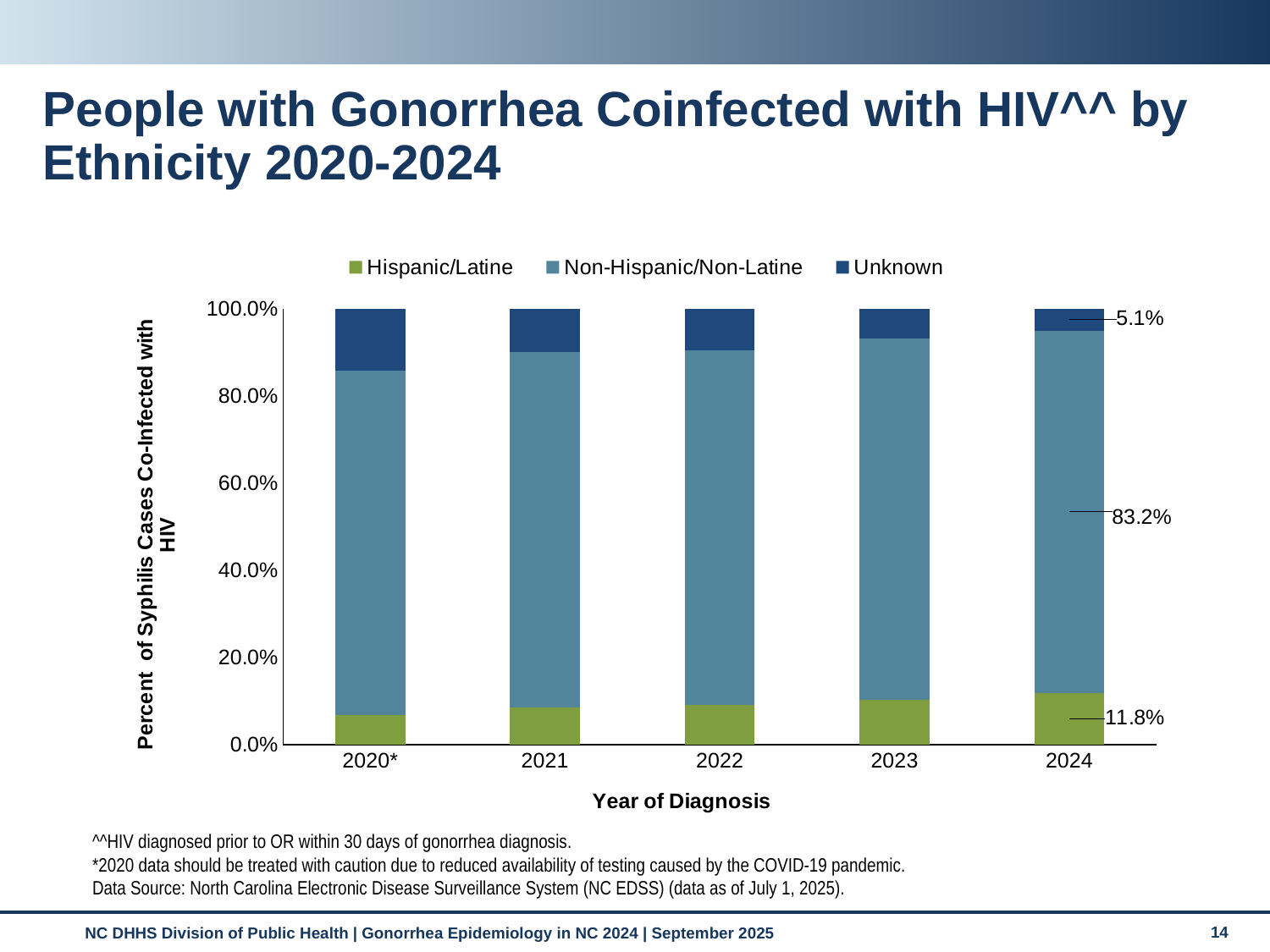
Which year has the largest Unknown share? 2020* Does the Hispanic/Latine share rise or fall from 2020* to 2024? Rise What is the Unknown ethnicity share shown for 2024? 5.1% How many years of diagnosis are shown on the x axis? 5 What percentage of people with gonorrhea coinfected with HIV in 2024 were Hispanic/Latine? 11.8% Is the Hispanic/Latine share for 2020* greater or less than 10%? less Does the Unknown share rise or fall from 2020* to 2024? Fall How many series does the legend list? 3 What kind of chart is shown on the slide? Stacked bar chart What is the title of the x axis? Year of Diagnosis Is the Unknown share for 2020* greater or less than 10%? greater What is the Non-Hispanic/Non-Latine share shown for 2024? 83.2%